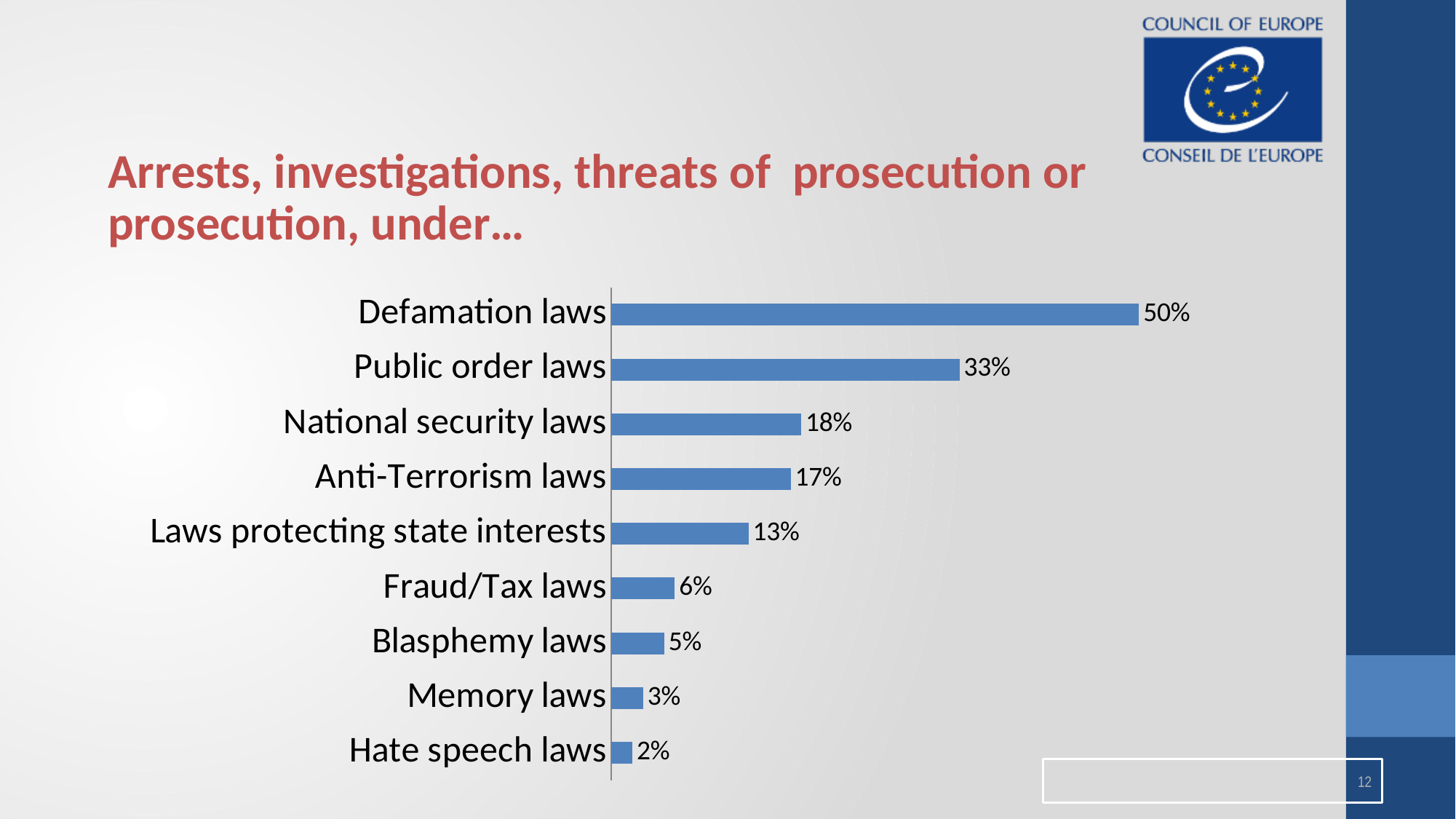
How many categories are shown in the chart? 9 What is the difference between the values for Defamation laws and Public order laws? 17% What is the value for Blasphemy laws? 5% What is the value for Defamation laws? 50% What is the difference between the values for National security laws and Anti-Terrorism laws? 1% What is the value for Public order laws? 33% Which is larger, the value for Fraud/Tax laws or the value for Memory laws? Fraud/Tax laws What is the title of the slide containing the chart? Arrests, investigations, threats of prosecution or prosecution, under... What is the value for Laws protecting state interests? 13% Which category has the lowest value? Hate speech laws What kind of chart is shown on the slide? Bar chart Which category has the highest value? Defamation laws